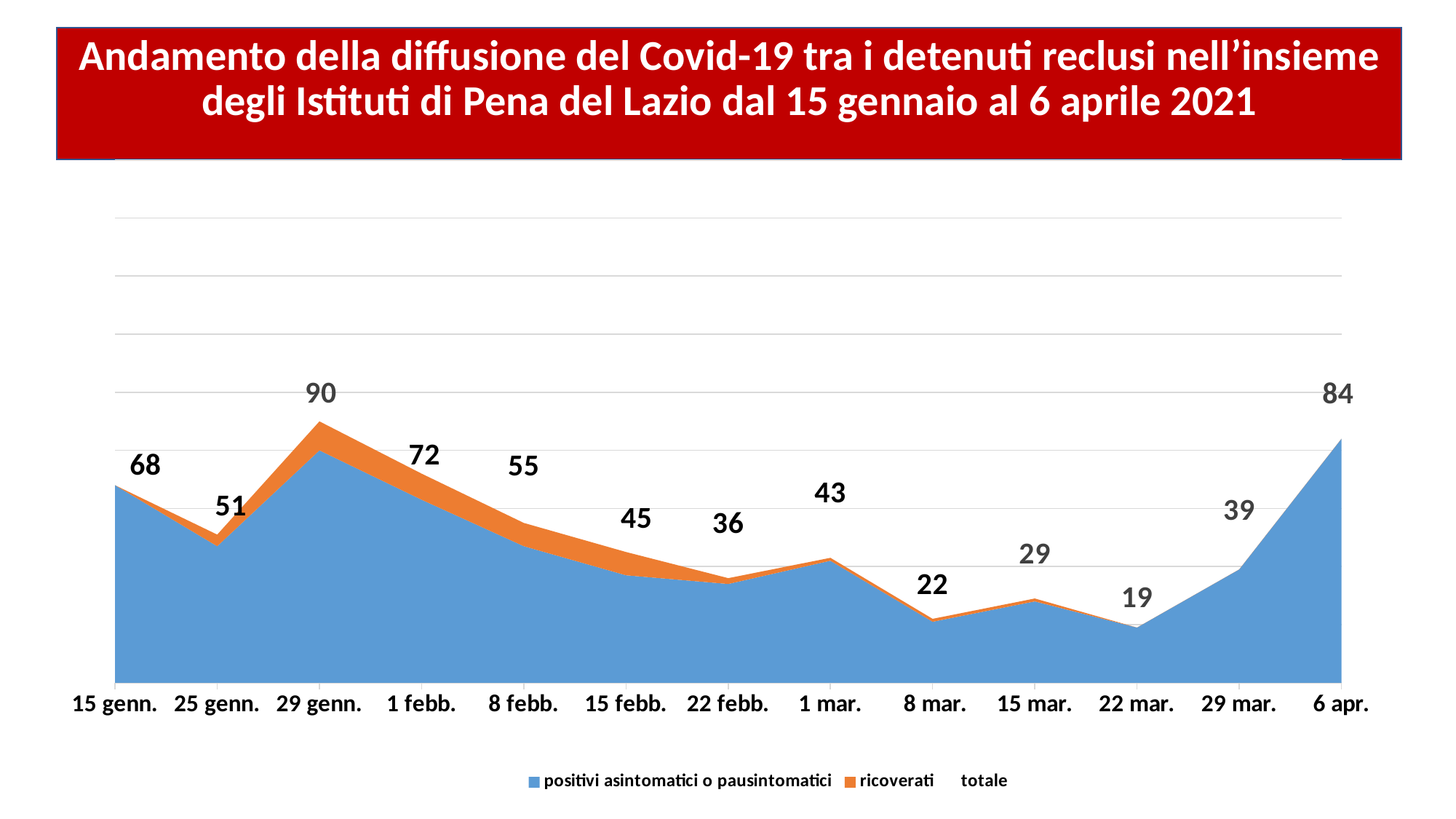
What is the total (totale) value shown for 6 apr.? 84 How many dates are shown on the x axis? 13 On which date is the total (totale) lowest? 22 mar. What is the total (totale) value shown for 29 genn.? 90 On which date is the total (totale) highest? 29 genn. Which series is shown in orange? ricoverati What is the difference between the total on 29 genn. and the total on 25 genn.? 39 What is the total (totale) value shown for 22 mar.? 19 How many series does the legend list? 3 What kind of chart is shown on the slide? area chart Does the total rise or fall from 29 genn. to 22 febb.? fall Which date has a larger total, 1 mar. or 8 mar.? 1 mar.